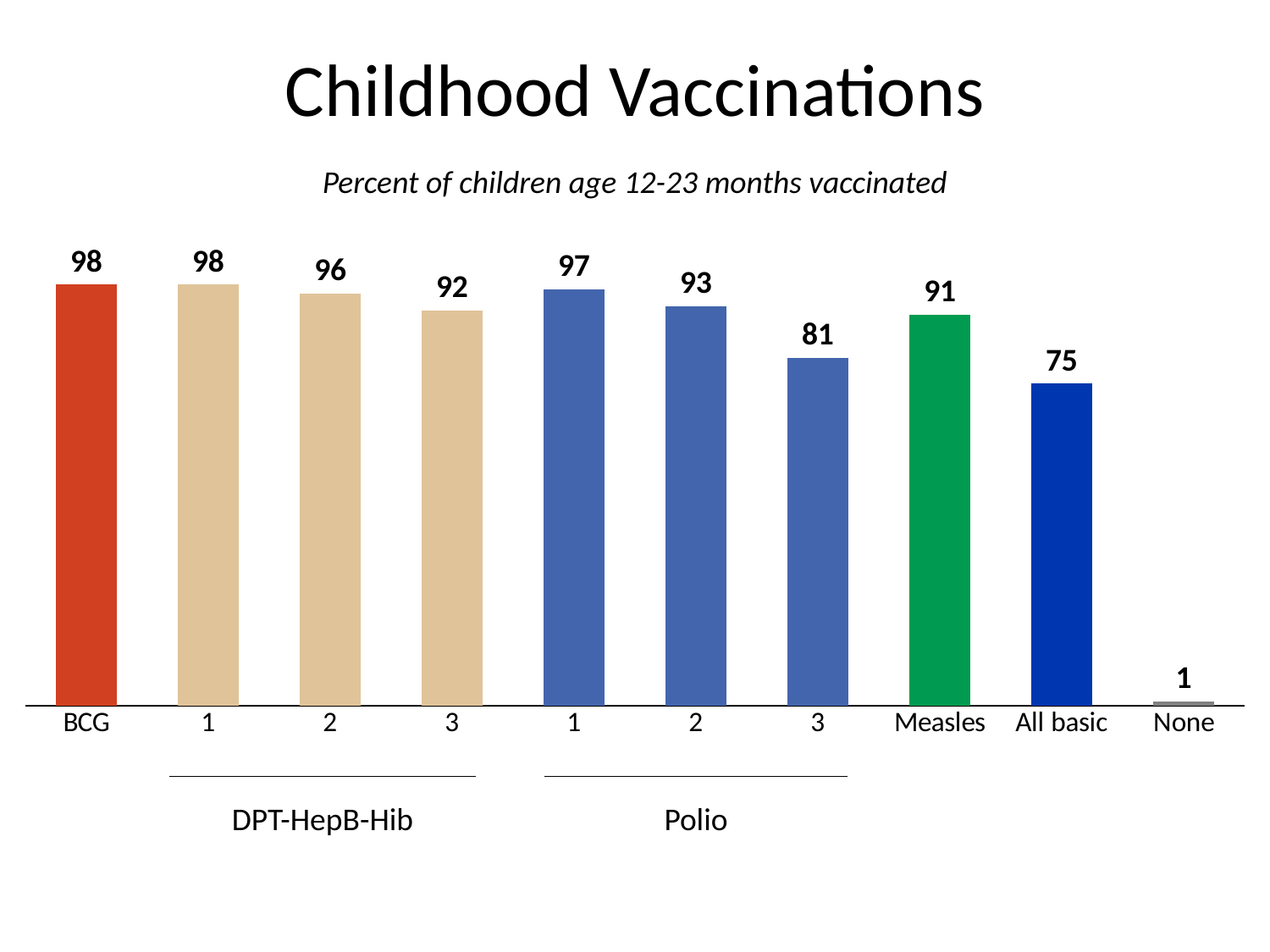
What is the difference between Measles and All basic? 16 Which category has the lowest value? None What kind of chart is this? Bar chart What is the difference between the first and third doses of Polio? 16 Which is larger, the third dose of DPT-HepB-Hib or the third dose of Polio? DPT-HepB-Hib dose 3 What is the value for Measles? 91 What is the value for All basic? 75 How many bars are shown in the chart? 10 What is the value for BCG? 98 What is the value for the third dose of Polio? 81 Do the values for the three Polio doses rise or fall from dose 1 to dose 3? Fall What is the value for the second dose of DPT-HepB-Hib? 96